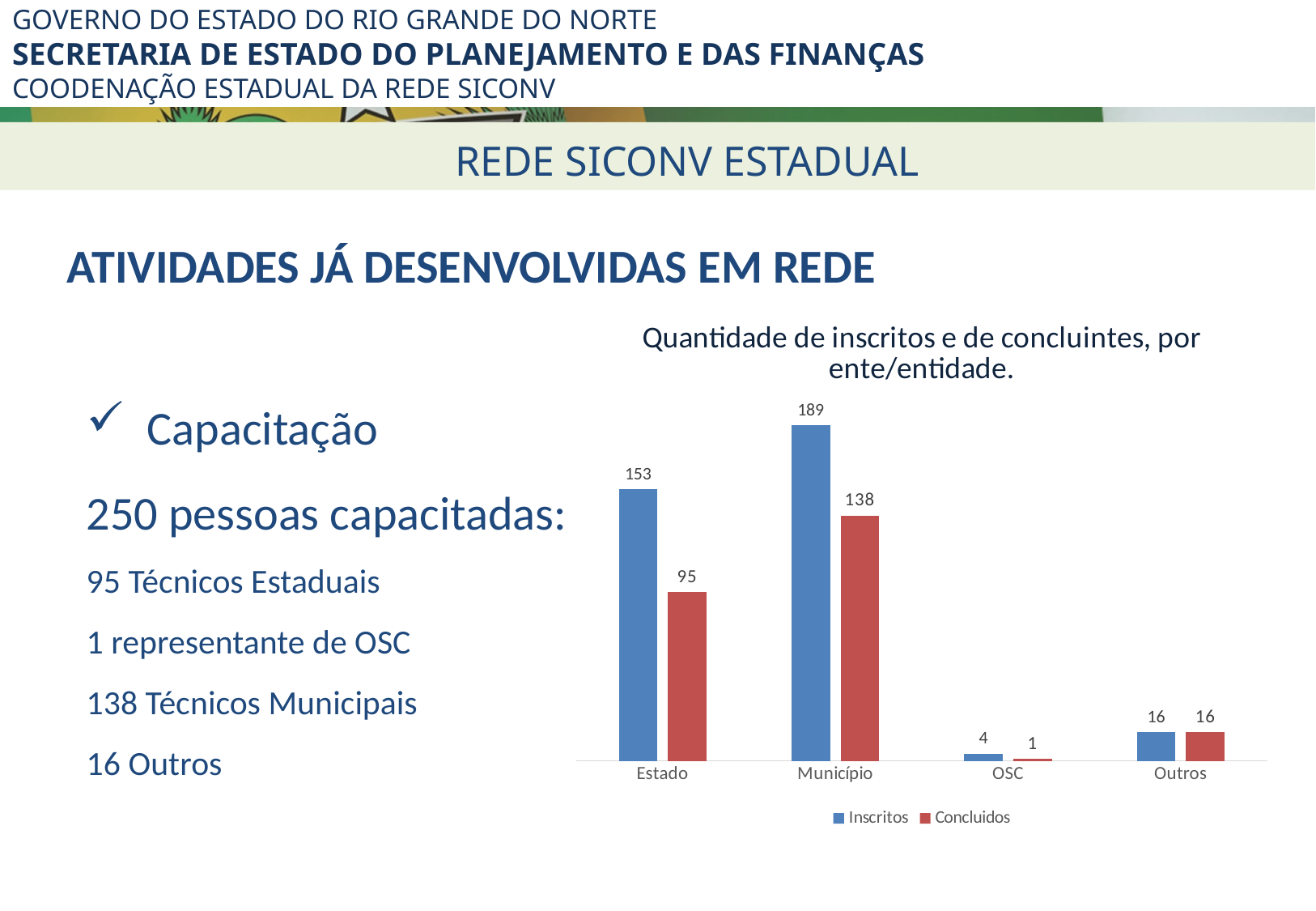
Which is larger, the Concluidos value for Estado or the Concluidos value for Município? Município What is the difference between the Inscritos values for Município and Estado? 36 How many series does the legend list? 2 What kind of chart is shown on the slide? Bar chart How many categories are shown on the x axis? 4 What is the Concluidos value for Município? 138 Which category has the lowest Concluidos value? OSC What is the Concluidos value for OSC? 1 What is the title of the chart? Quantidade de inscritos e de concluintes, por ente/entidade. What is the difference between Inscritos and Concluidos for Estado? 58 What is the Inscritos value for Estado? 153 Which category has the highest Inscritos value? Município